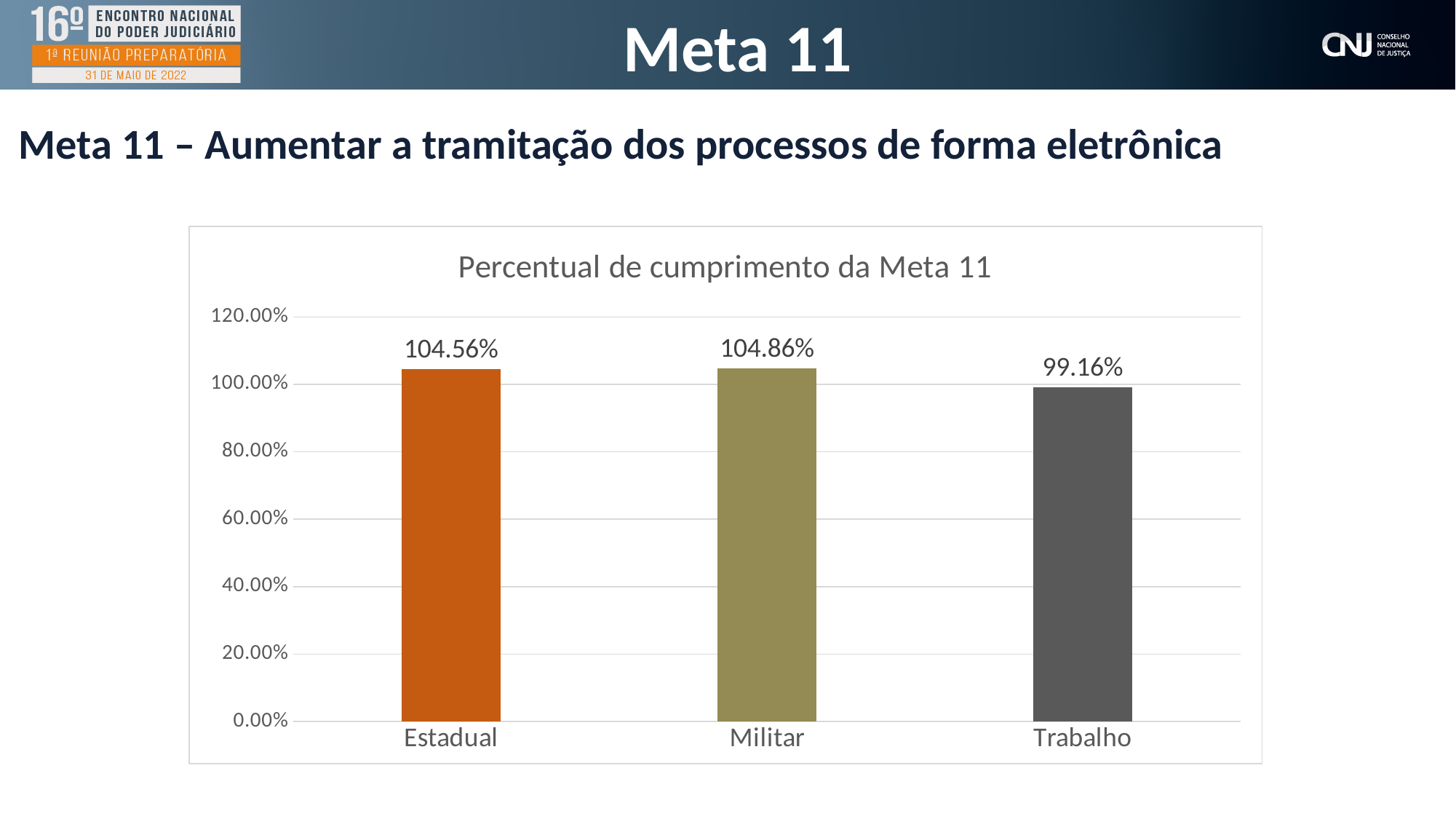
What is the value for Trabalho in the chart? 99.16% Is the value for Trabalho greater or less than 80.00%? greater What is the difference between the values for Estadual and Trabalho? 5.40% Which category has the lowest value in the chart? Trabalho What is the value for Militar in the chart? 104.86% What kind of chart is shown on the slide? bar chart Which is larger, the value for Estadual or the value for Trabalho? Estadual What is the title of the chart? Percentual de cumprimento da Meta 11 What is the value for Estadual in the chart? 104.56% What is the difference between the values for Militar and Trabalho? 5.70% How many categories are shown in the chart? 3 Which category has the highest value in the chart? Militar